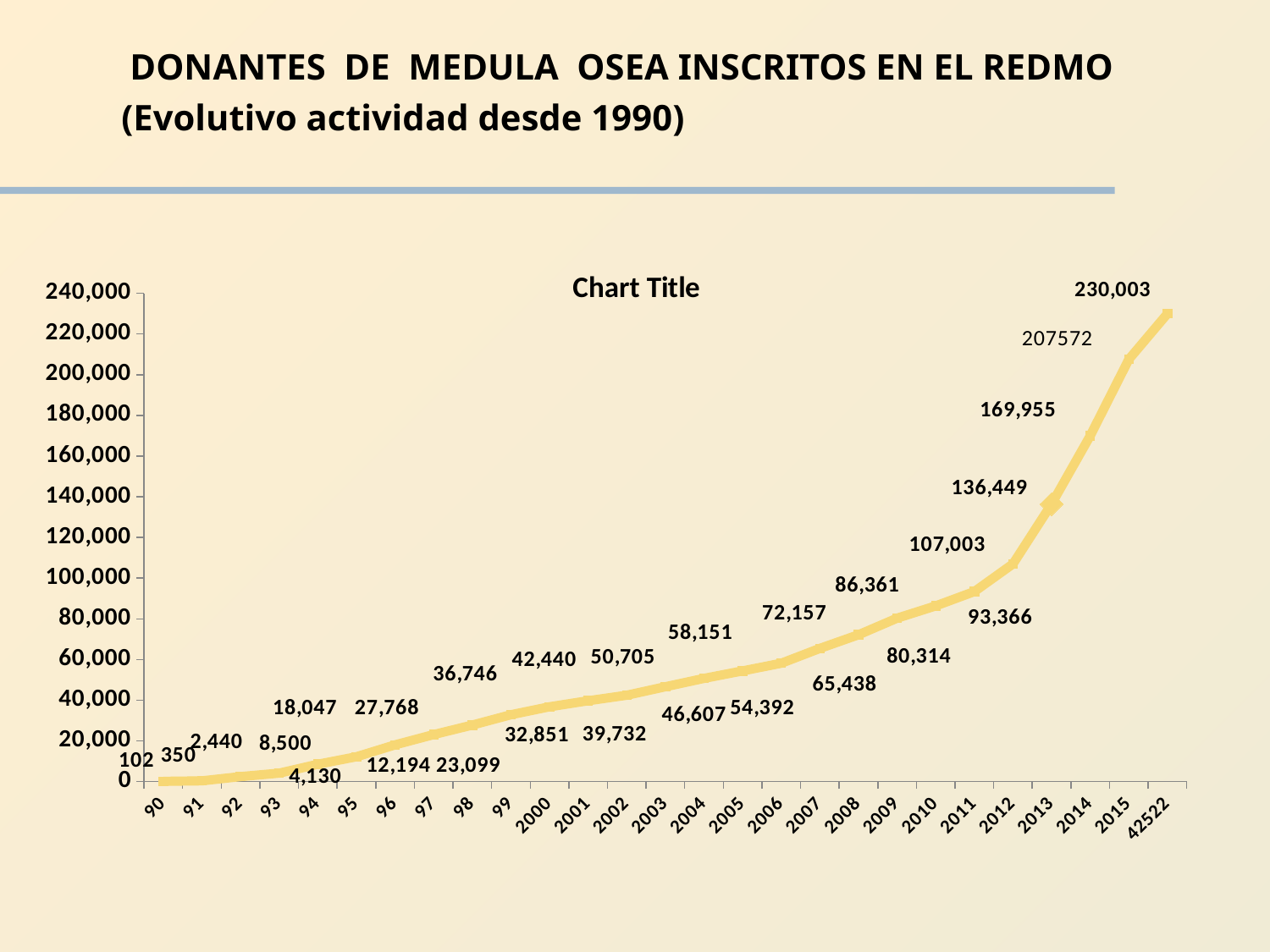
What is the highest value plotted on the chart? 230,003 What is the difference between the 2014 value and the 2013 value? 33,506 What is the value labelled for 2015? 207572 What is the value labelled for the last point on the chart (category 42522)? 230,003 What kind of chart is shown on the slide? line chart What is the value labelled for 2013? 136,449 Do the values rise or fall along the x axis from 90 to the last point? rise What is the value labelled for 2014? 169,955 What is the lowest value plotted on the chart? 102 Is the value for 2010 greater or less than 100,000? less What is the difference between the last point (230,003) and the 2015 value (207572)? 22,431 How many categories are shown on the x axis? 27